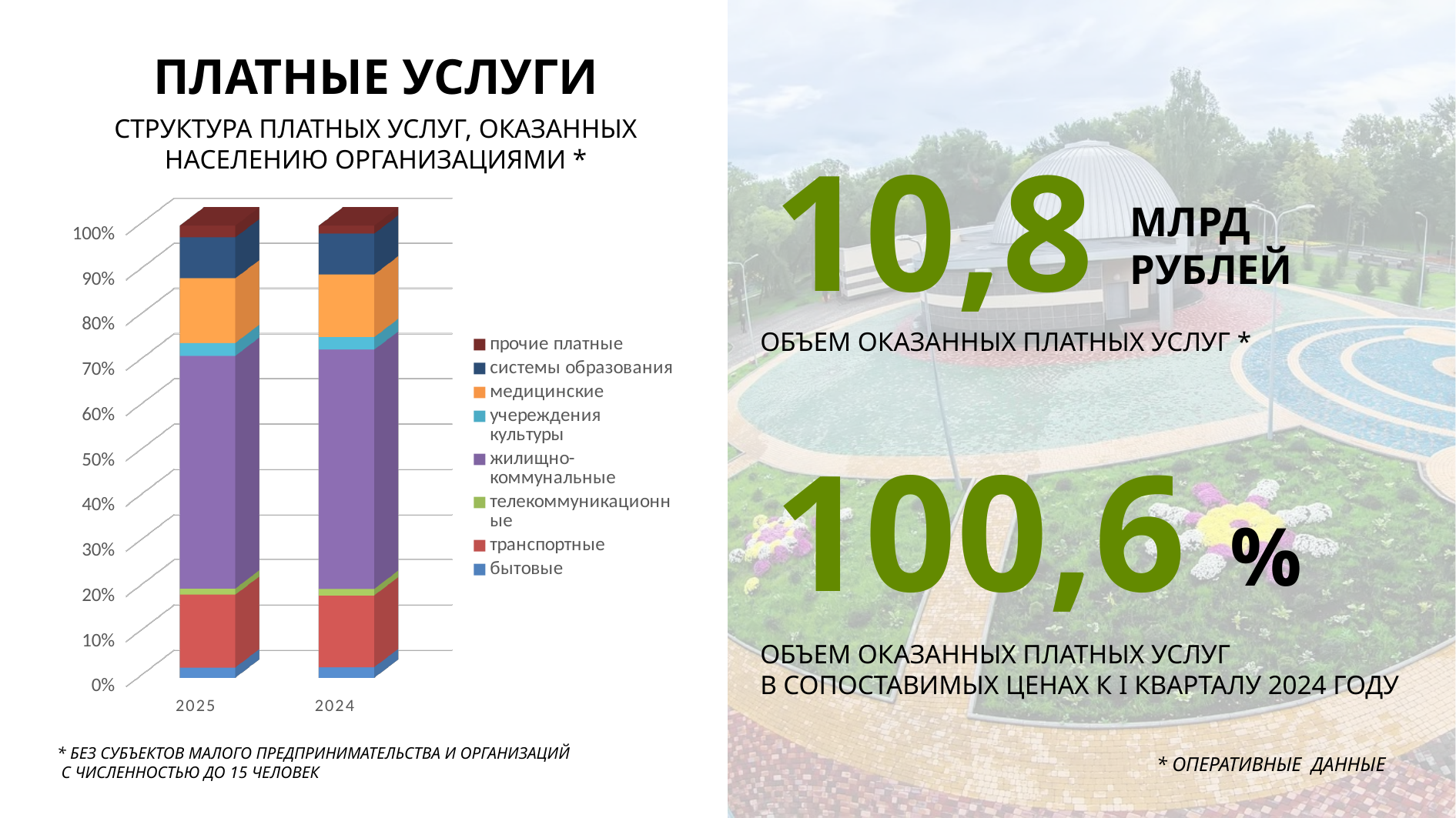
How many series does the chart legend list? 8 Is the share of транспортные services in 2025 greater or less than 30%? less Is the share of медицинские services in 2025 greater or less than 20%? less In the 2025 bar, which segment is larger: жилищно-коммунальные or транспортные? жилищно-коммунальные What is the subtitle of the chart on the slide? СТРУКТУРА ПЛАТНЫХ УСЛУГ, ОКАЗАННЫХ НАСЕЛЕНИЮ ОРГАНИЗАЦИЯМИ * Which series is shown in purple in the chart legend? жилищно-коммунальные What kind of chart is shown on the slide? stacked bar chart In the 2024 bar, which segment is larger: медицинские or учреждения культуры? медицинские Is the share of жилищно-коммунальные services in 2025 greater or less than 40%? greater How many years (categories) are shown on the x axis of the chart? 2 Which service type has the largest share in the 2025 bar? жилищно-коммунальные